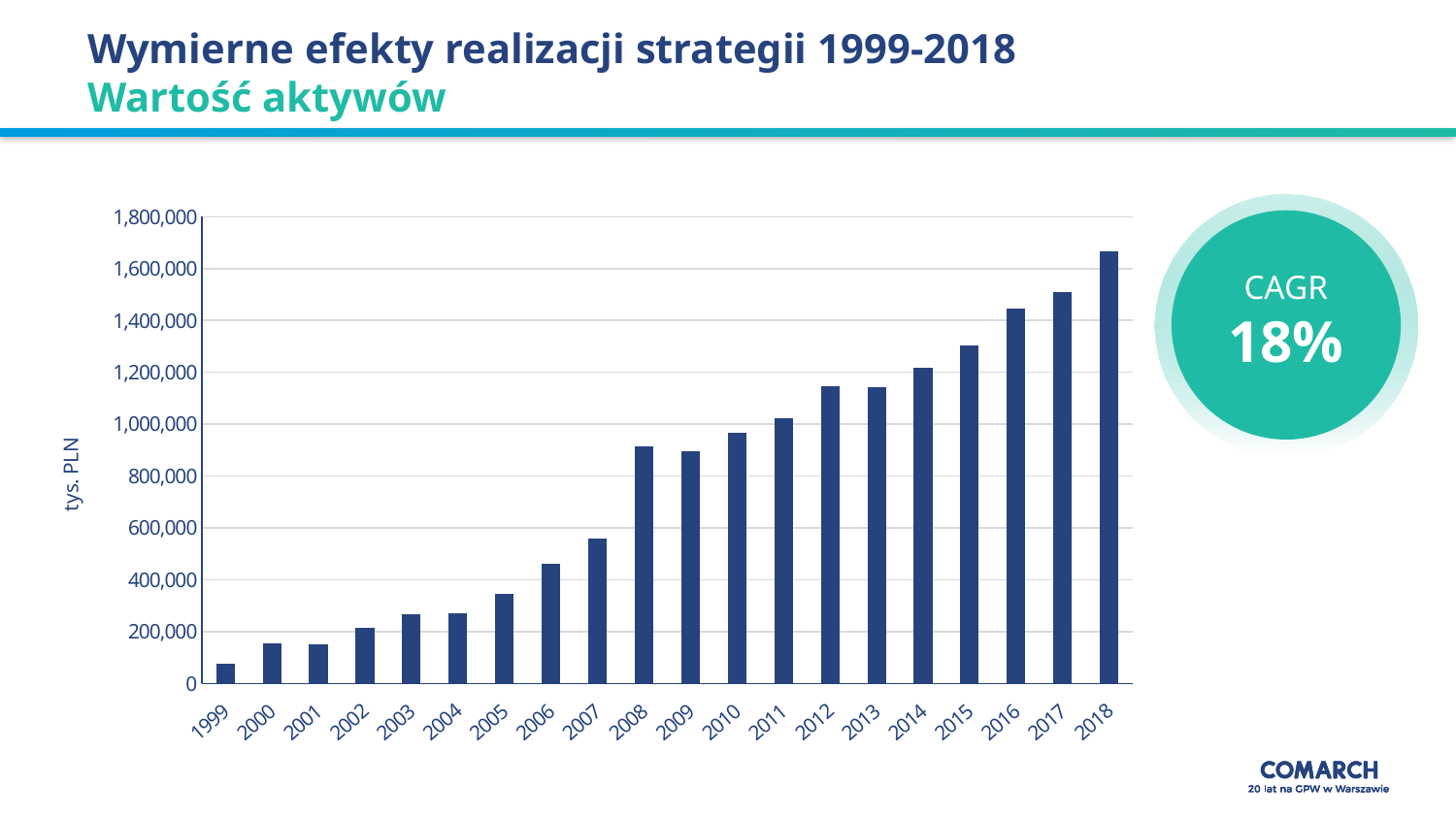
Is the value for 2005 greater or less than 400,000? less Which year has the lowest value of assets on the chart? 1999 Is the value for 1999 greater or less than 200,000? less What kind of chart is shown on the slide? bar chart Is the value for 2018 greater or less than 1,600,000? greater Which year has the larger value, 2006 or 2007? 2007 How many years (bars) are plotted on the chart? 20 Which year has the highest value of assets on the chart? 2018 What unit is shown on the vertical axis label of the chart? tys. PLN Do the values generally rise or fall from 1999 to 2018? rise